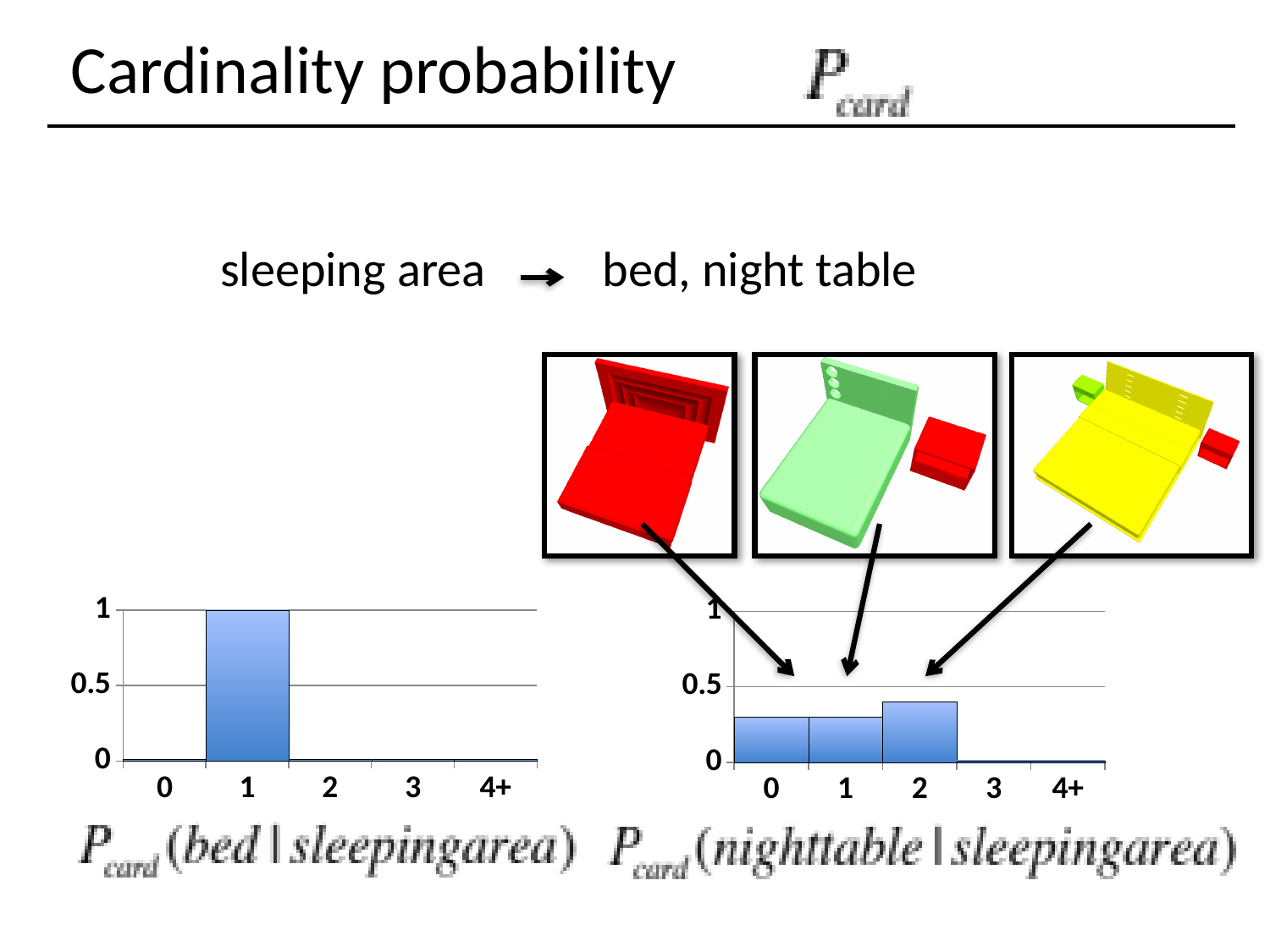
What kind of chart is the left chart, P_card(bed | sleepingarea)? bar chart In the left chart, P_card(bed | sleepingarea), which is larger, the value for category 1 or the value for category 2? 1 What is the label of the last category on the x axis of the left chart? 4+ In the right chart, P_card(nighttable | sleepingarea), which category has the highest value? 2 In the left chart, P_card(bed | sleepingarea), what is the value for category 1? 1 In the right chart, P_card(nighttable | sleepingarea), is the value for category 2 greater or less than 0.5? less How many categories are shown on the x axis of the right chart, P_card(nighttable | sleepingarea)? 5 In the left chart, P_card(bed | sleepingarea), which category has the highest value? 1 In the right chart, P_card(nighttable | sleepingarea), is the value for category 0 greater or less than 0.5? less What is the highest tick value shown on the y axis of the right chart, P_card(nighttable | sleepingarea)? 1 In the right chart, P_card(nighttable | sleepingarea), which is larger, the value for category 2 or the value for category 3? 2